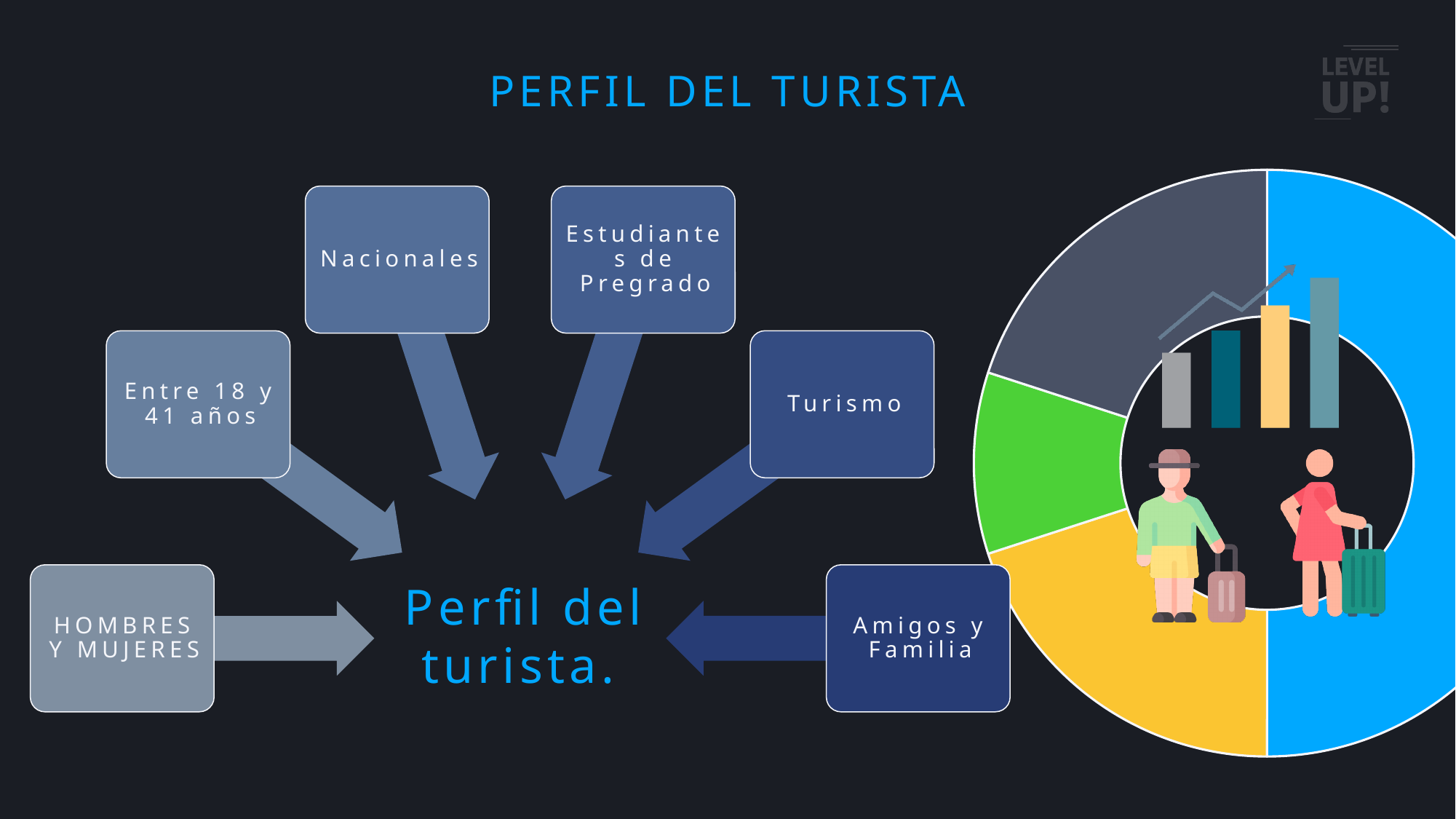
In the donut chart on the right of the slide, is the blue slice larger or smaller than the yellow slice? Larger Which colour slice is the largest in the donut chart on the right of the slide? Blue Which colour slice is the smallest in the donut chart on the right of the slide? Green Does the donut chart on the right of the slide show a legend? No What kind of chart is shown on the right side of the slide? Pie chart (donut) How many slices does the donut chart on the right of the slide have? 4 What is the title of the slide containing the donut chart? PERFIL DEL TURISTA